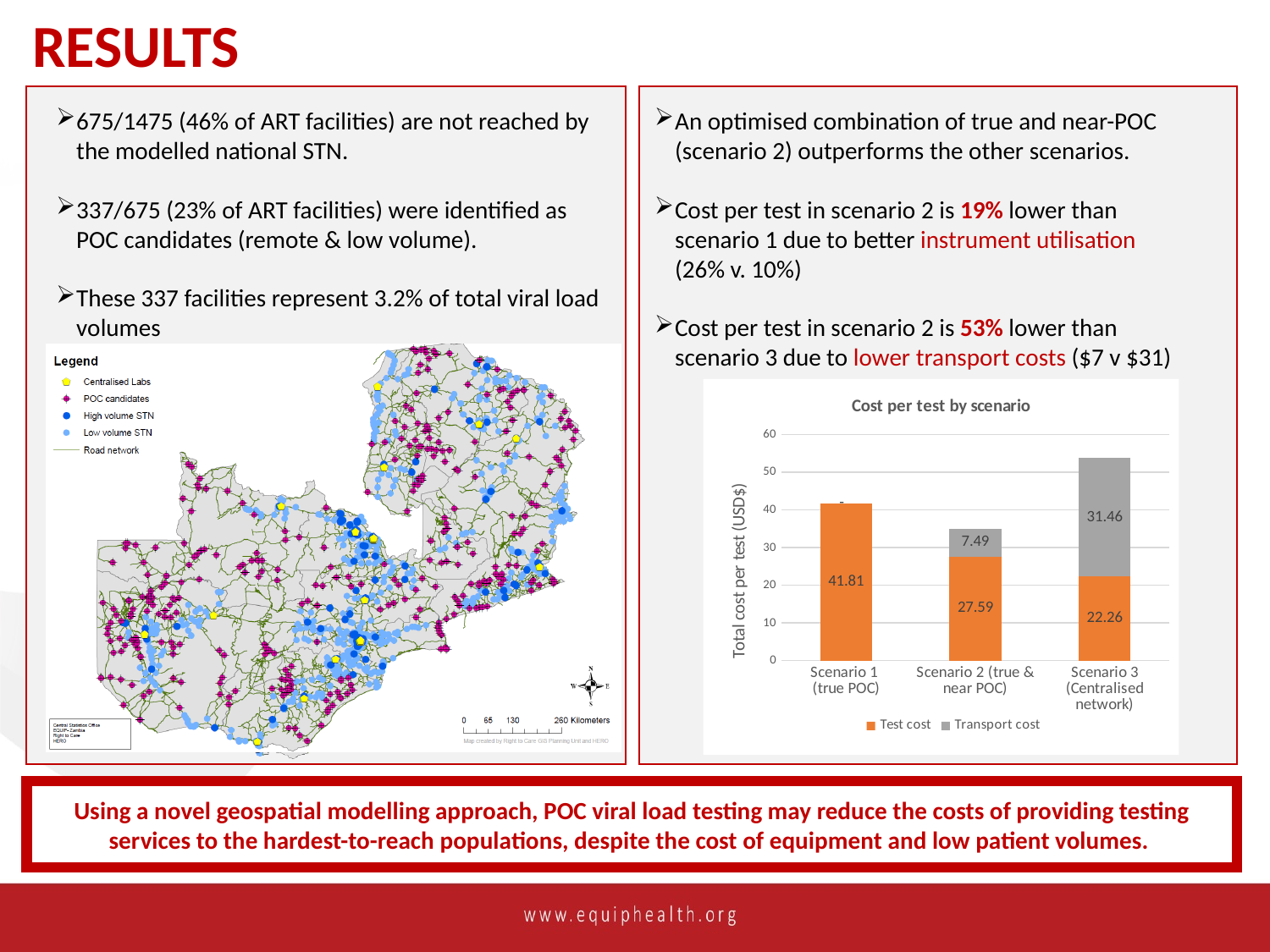
In the 'Cost per test by scenario' chart, which scenario has the highest test cost? Scenario 1 (true POC) In the 'Cost per test by scenario' chart, which has the larger transport cost, Scenario 2 or Scenario 3? Scenario 3 In the 'Cost per test by scenario' chart, what is the test cost for Scenario 1 (true POC)? 41.81 In the 'Cost per test by scenario' chart, what is the total cost per test for Scenario 2 (test cost plus transport cost)? 35.08 In the 'Cost per test by scenario' chart, what is the total cost per test for Scenario 3 (test cost plus transport cost)? 53.72 In the 'Cost per test by scenario' chart, which scenario has the lowest test cost? Scenario 3 (Centralised network) In the 'Cost per test by scenario' chart, what is the test cost for Scenario 2 (true & near POC)? 27.59 In the 'Cost per test by scenario' chart, what is the transport cost for Scenario 2 (true & near POC)? 7.49 In the 'Cost per test by scenario' chart, what is the transport cost for Scenario 3 (Centralised network)? 31.46 How many series does the legend of the 'Cost per test by scenario' chart list? 2 What type of chart is 'Cost per test by scenario'? Stacked bar chart In the 'Cost per test by scenario' chart, how much higher is the test cost in Scenario 1 than in Scenario 2? 14.22